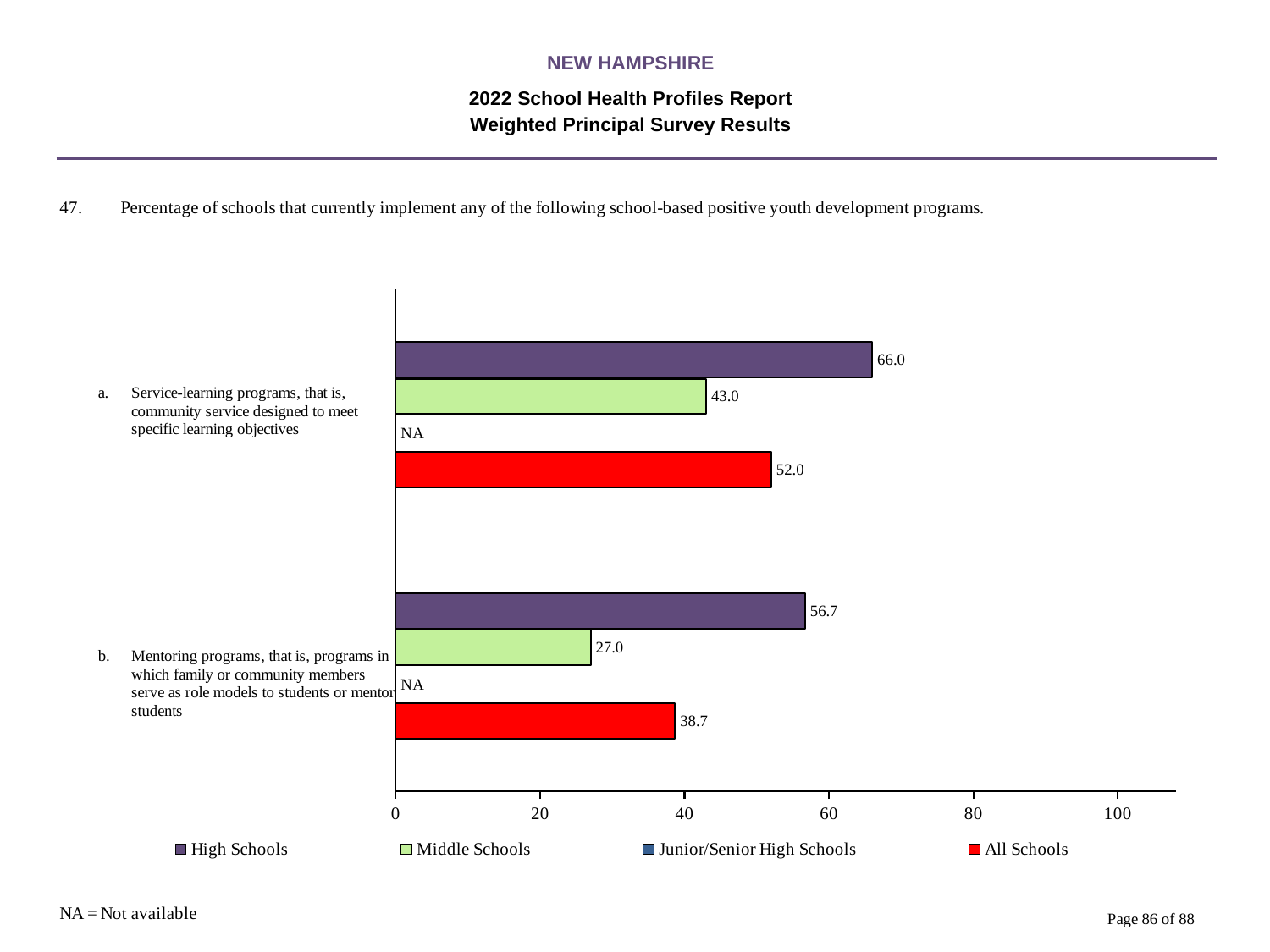
Which is larger: the All Schools value for service-learning programs (item a) or the All Schools value for mentoring programs (item b)? Service-learning programs (item a) What is the value for High Schools for service-learning programs (item a)? 66.0 How many series does the legend list? 4 What is shown for Junior/Senior High Schools for mentoring programs (item b)? NA What is the value for All Schools for service-learning programs (item a)? 52.0 Is the High Schools value for mentoring programs (item b) greater or less than 60? less Which school type has the lowest plotted value for service-learning programs (item a)? Middle Schools What is the value for Middle Schools for mentoring programs (item b)? 27.0 What kind of chart is shown on the slide? Bar chart What colour are the All Schools bars? Red What is the difference between the High Schools and Middle Schools values for service-learning programs (item a)? 23.0 Which school type has the highest value for mentoring programs (item b)? High Schools